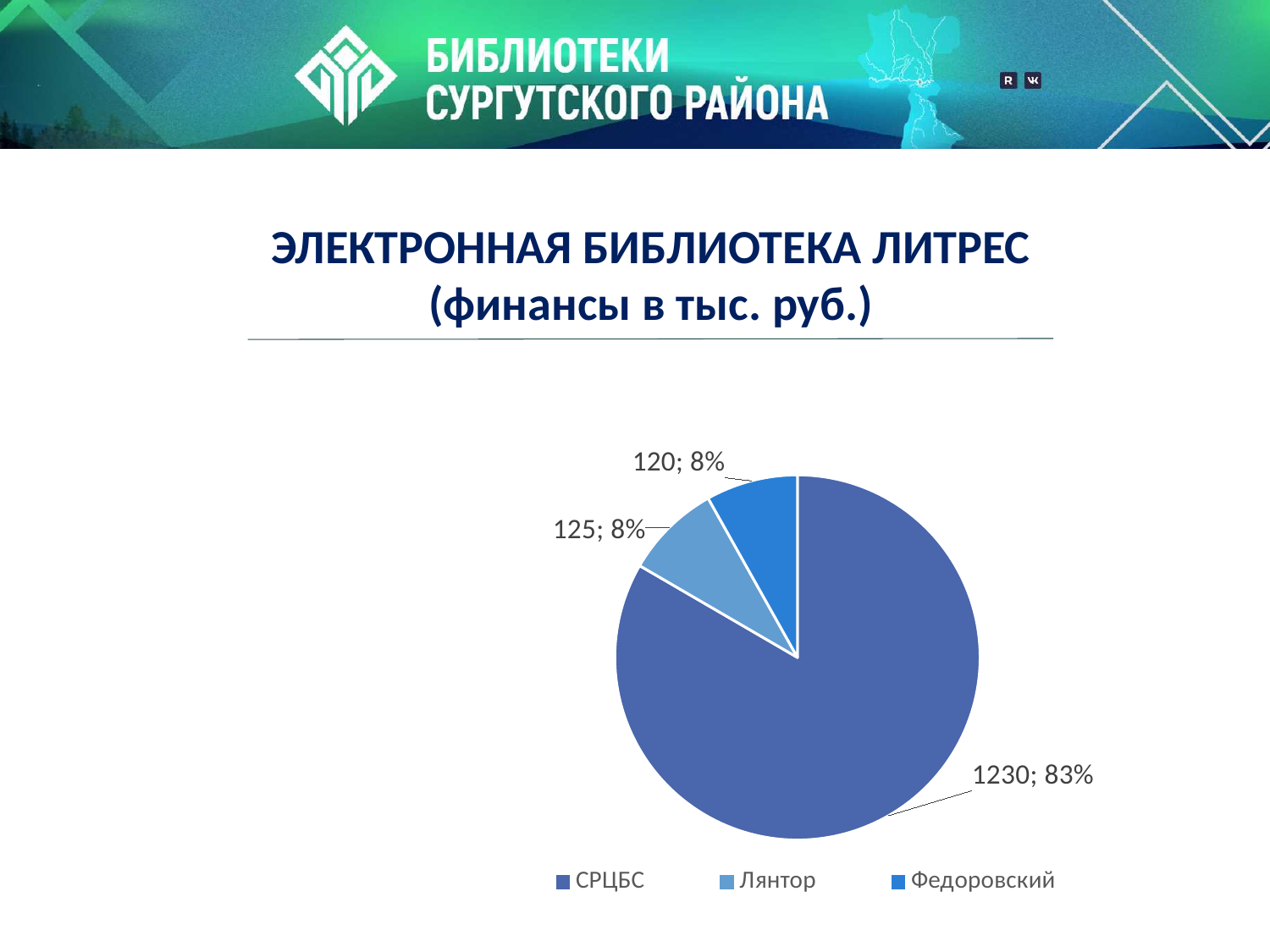
What share of the pie does СРЦБС take? 83% What share of the pie does Лянтор take? 8% What is the value for Федоровский? 120 What kind of chart is shown on the slide? pie chart Which category has the largest slice? СРЦБС Which is larger, the value for Лянтор or the value for Федоровский? Лянтор What is the difference between the values for СРЦБС and Лянтор? 1105 Which category has the smallest value? Федоровский How many slices does the pie chart have? 3 What is the value for Лянтор? 125 What is the title of the chart? ЭЛЕКТРОННАЯ БИБЛИОТЕКА ЛИТРЕС (финансы в тыс. руб.) What is the value for СРЦБС? 1230